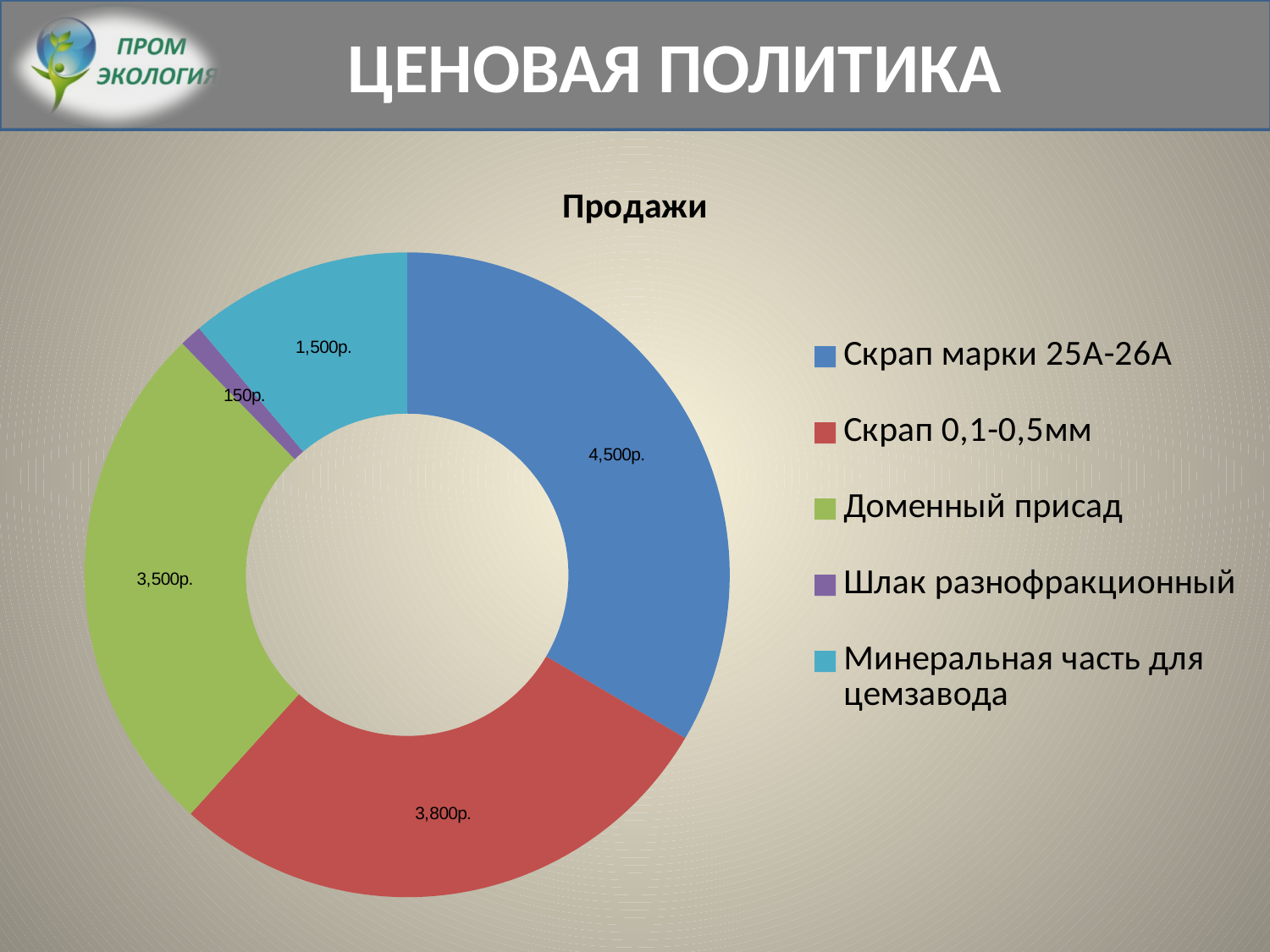
What is the title of the chart? Продажи What is the value shown for Шлак разнофракционный? 150р. What is the value shown for Скрап марки 25А-26А? 4,500р. What is the difference between the values for Скрап марки 25А-26А and Скрап 0,1-0,5мм? 700р. Which category has the highest value? Скрап марки 25А-26А What is the value shown for Скрап 0,1-0,5мм? 3,800р. Which category has the lowest value? Шлак разнофракционный How many categories does the chart show? 5 What is the value shown for Доменный присад? 3,500р. Which is larger, the value for Доменный присад or the value for Минеральная часть для цемзавода? Доменный присад What is the value shown for Минеральная часть для цемзавода? 1,500р. What kind of chart is shown on the slide? Doughnut chart